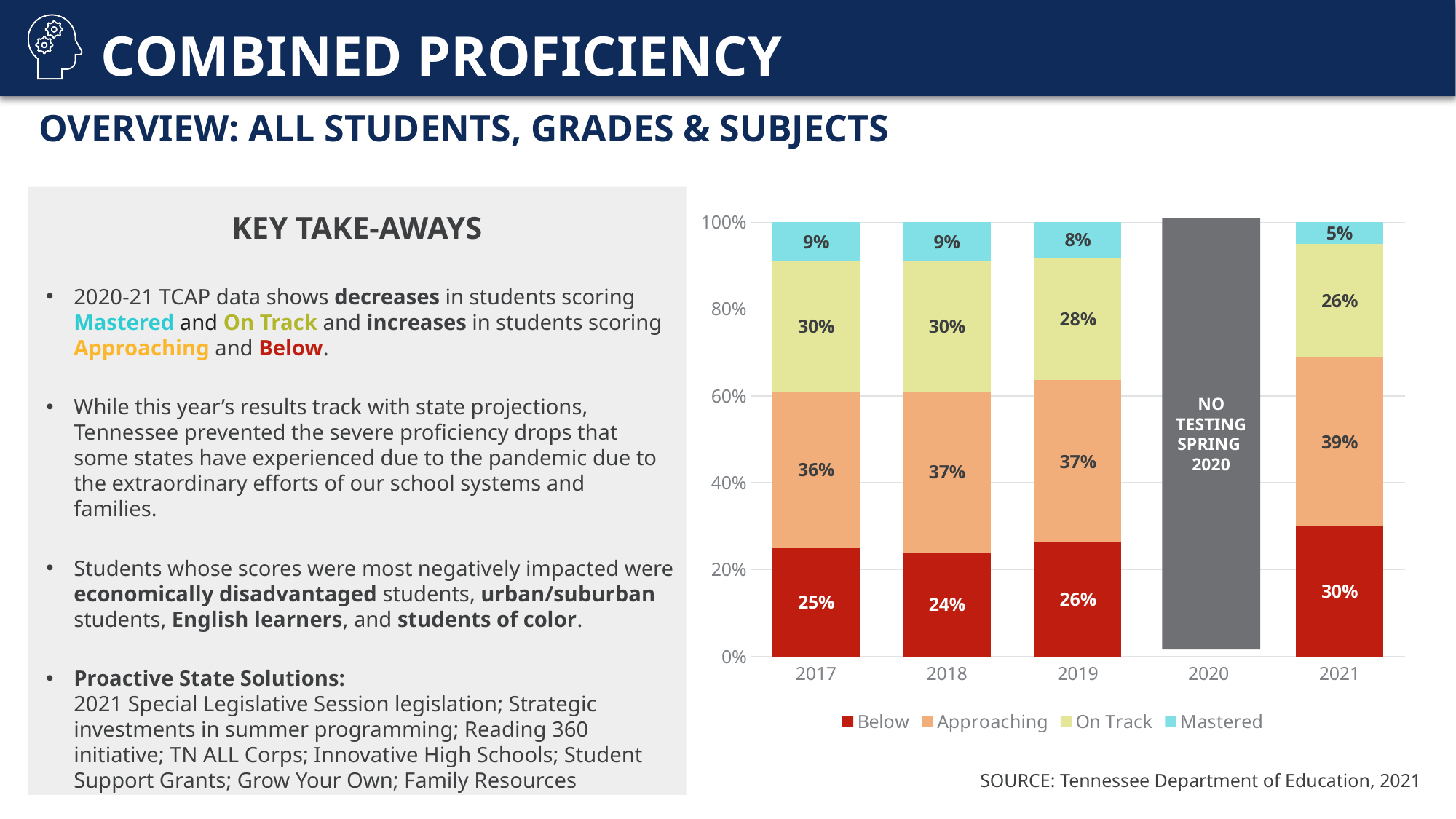
What percentage of students scored On Track in 2017? 30% What does the grey bar for 2020 indicate? No testing spring 2020 What kind of chart is shown on the slide? Stacked bar chart How does the Mastered percentage change from 2017 to 2021? It falls How many series does the legend list? 4 Is the On Track percentage larger in 2019 or in 2021? 2019 Which year has the lowest percentage of students scoring Mastered? 2021 What is the difference between the Approaching percentage in 2021 and in 2017? 3% What percentage of students scored Below in 2021? 30% What percentage of students scored Approaching in 2018? 37% Which year has the highest percentage of students scoring Below? 2021 What percentage of students scored Mastered in 2019? 8%